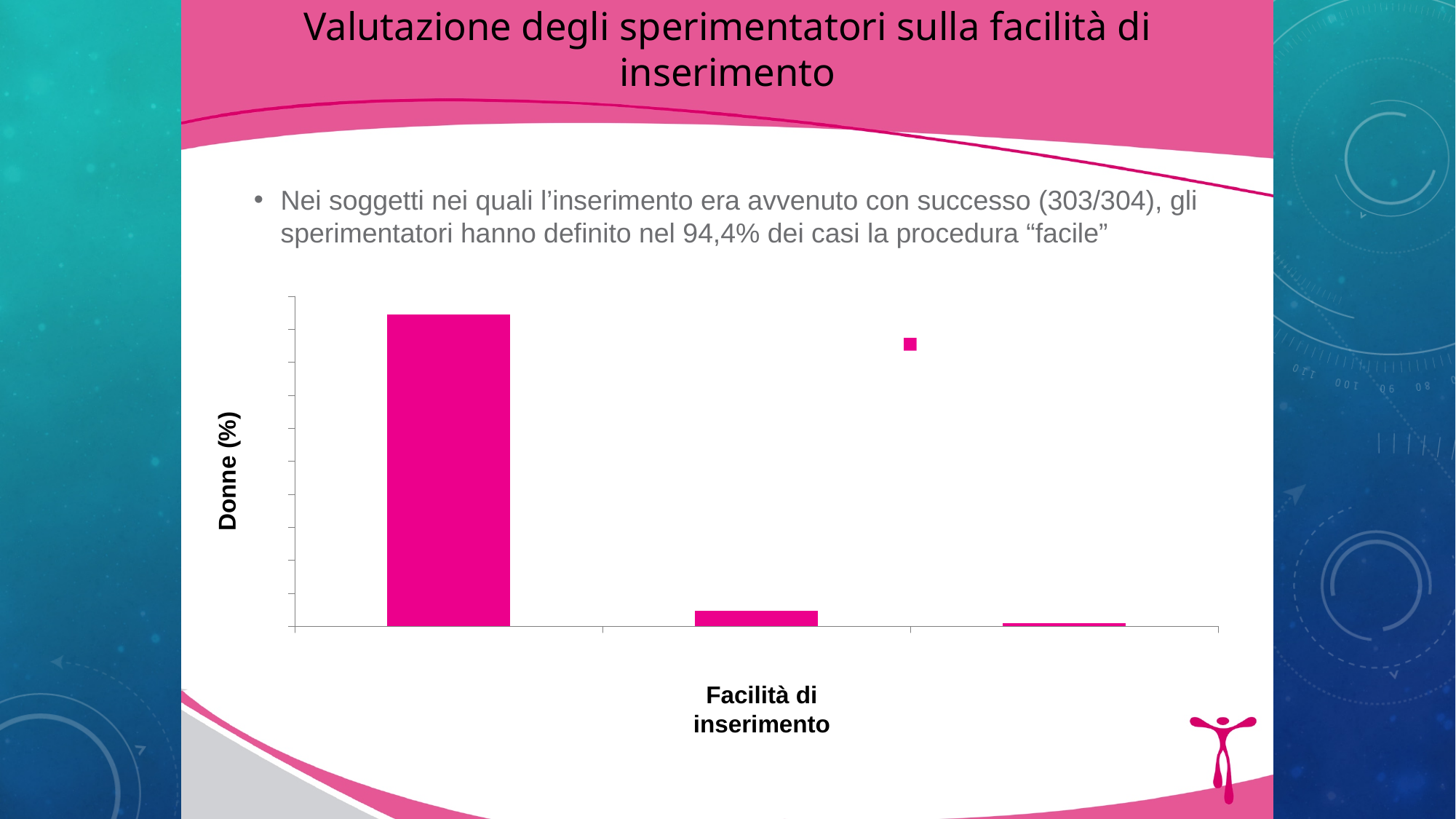
What is the title of the vertical axis of the chart? Donne (%) Do the bar heights rise or fall from left to right along the x axis? fall Which bar is the shortest in the chart: the left, middle, or right one? the right one Is the middle bar or the right bar taller in the chart? the middle bar Which bar is the tallest in the chart: the left, middle, or right one? the left one How many bars are plotted in the chart? 3 What is the title of the horizontal axis of the chart? Facilità di inserimento Is the left bar or the middle bar taller in the chart? the left bar What kind of chart is shown on the slide? bar chart